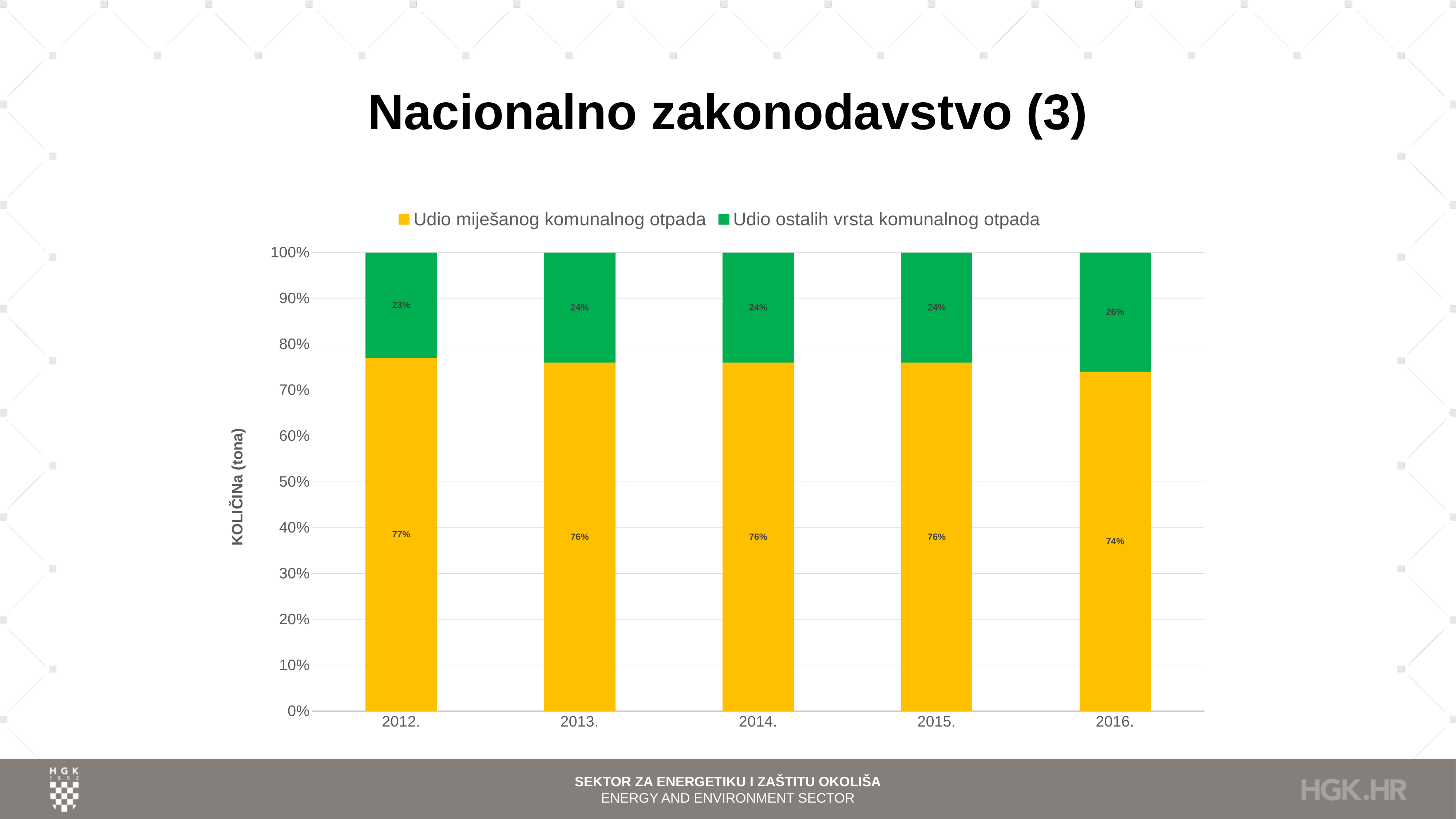
What is the value of 'Udio miješanog komunalnog otpada' for 2012.? 77% How many series does the legend list? 2 What kind of chart is shown on the slide? Stacked bar chart How many years are shown on the x axis? 5 What is the value of 'Udio ostalih vrsta komunalnog otpada' for 2012.? 23% What is the value of 'Udio ostalih vrsta komunalnog otpada' for 2016.? 26% Which year has the highest value for 'Udio ostalih vrsta komunalnog otpada'? 2016. Which is larger in 2014.: 'Udio miješanog komunalnog otpada' or 'Udio ostalih vrsta komunalnog otpada'? Udio miješanog komunalnog otpada Which year has the lowest value for 'Udio miješanog komunalnog otpada'? 2016. What is the label of the vertical axis? KOLIČINa (tona) What is the value of 'Udio miješanog komunalnog otpada' for 2015.? 76% What is the difference between 'Udio miješanog komunalnog otpada' in 2012. and in 2016.? 3%